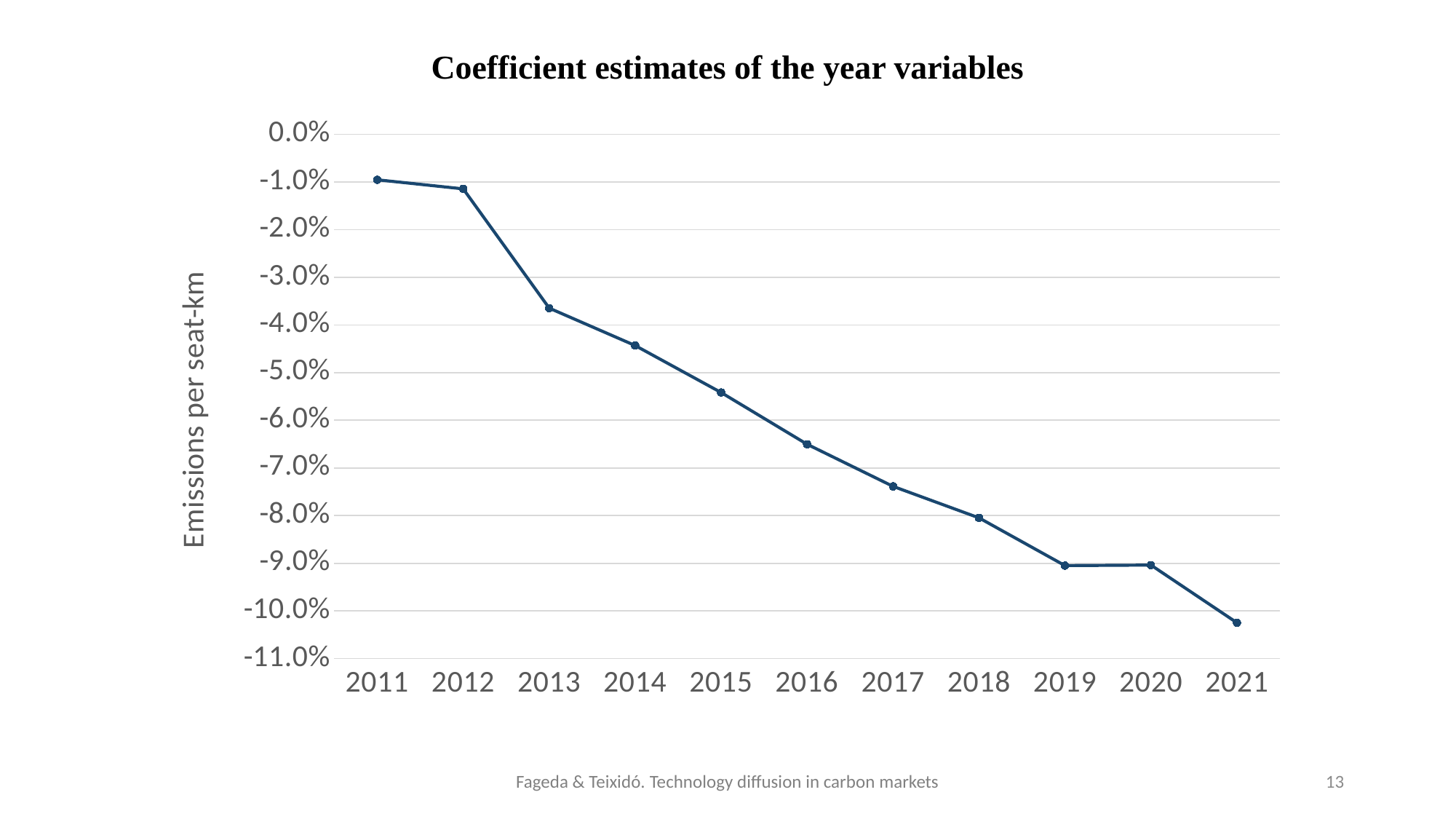
What is the title of the chart? Coefficient estimates of the year variables How many years are plotted on the x axis? 11 Do the coefficient estimates rise or fall from 2011 to 2021? fall Which year has the larger coefficient estimate, 2013 or 2014? 2013 Is the value for 2016 greater or less than -6.0%? less What is the label on the vertical axis? Emissions per seat-km Is the value for 2011 greater or less than -2.0%? greater Which year has the lowest coefficient estimate? 2021 Which year has the highest coefficient estimate (closest to 0.0%)? 2011 Is the value for 2021 greater or less than -10.0%? less What kind of chart is shown on the slide? line chart